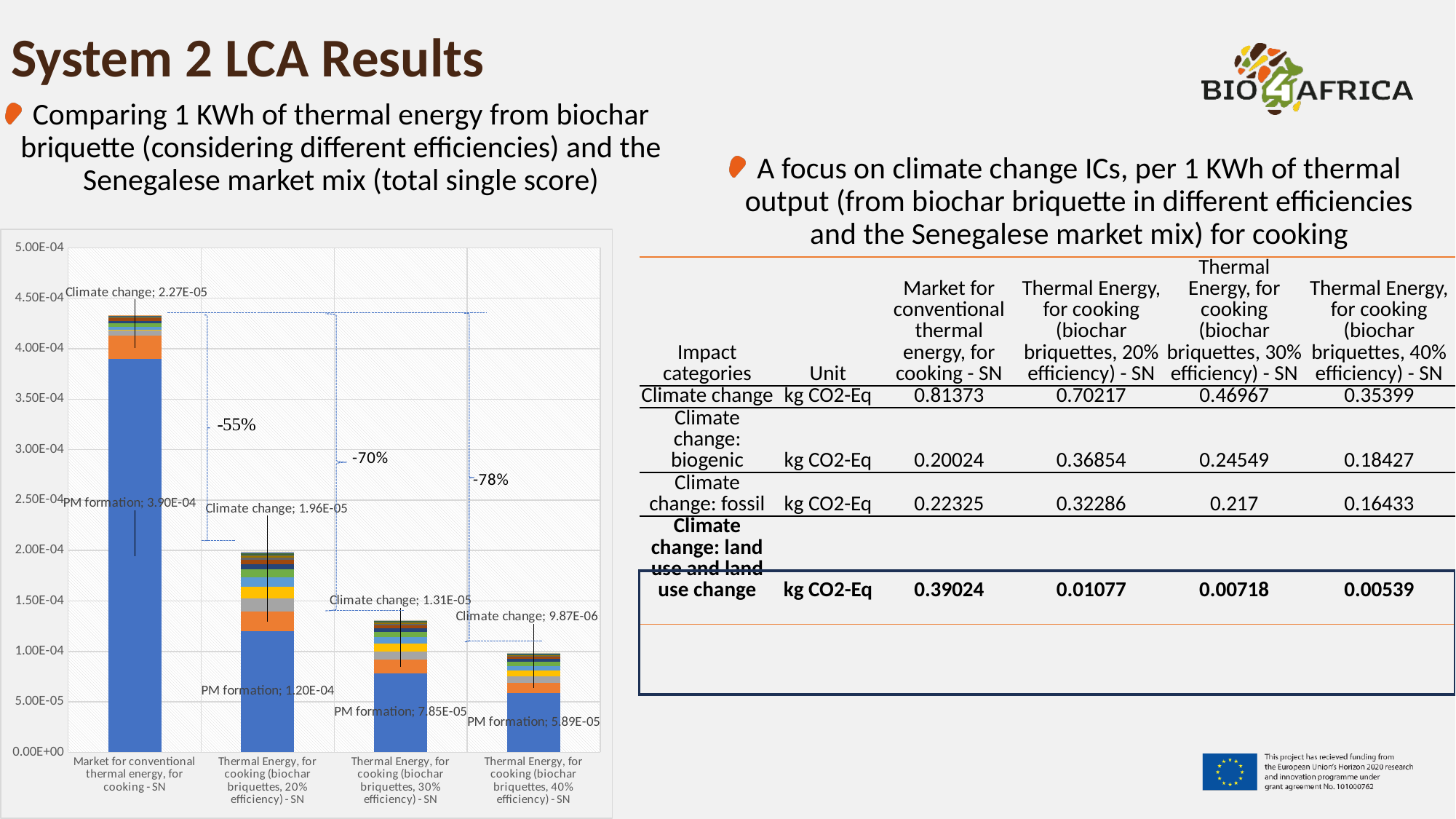
What is the Climate change value for 'Thermal Energy, for cooking (biochar briquettes, 30% efficiency) - SN'? 1.31E-05 What is the PM formation value for 'Thermal Energy, for cooking (biochar briquettes, 40% efficiency) - SN'? 5.89E-05 What is the PM formation value for 'Market for conventional thermal energy, for cooking - SN'? 3.90E-04 What kind of chart is shown on the left of the slide? Stacked bar chart Which category has the lowest total bar in the chart? Thermal Energy, for cooking (biochar briquettes, 40% efficiency) - SN What percentage reduction is annotated between the conventional thermal energy bar and the 40% efficiency biochar briquettes bar? -78% How many bars (categories) are plotted in the chart? 4 What is the Climate change value for 'Thermal Energy, for cooking (biochar briquettes, 20% efficiency) - SN'? 1.96E-05 Is the PM formation value larger for the 20% efficiency biochar briquettes or the 30% efficiency biochar briquettes? 20% efficiency Is the total bar for 'Thermal Energy, for cooking (biochar briquettes, 20% efficiency) - SN' greater or less than 2.50E-04? less Do the total bar heights rise or fall from left to right across the categories? fall Which category has the highest total bar in the chart? Market for conventional thermal energy, for cooking - SN